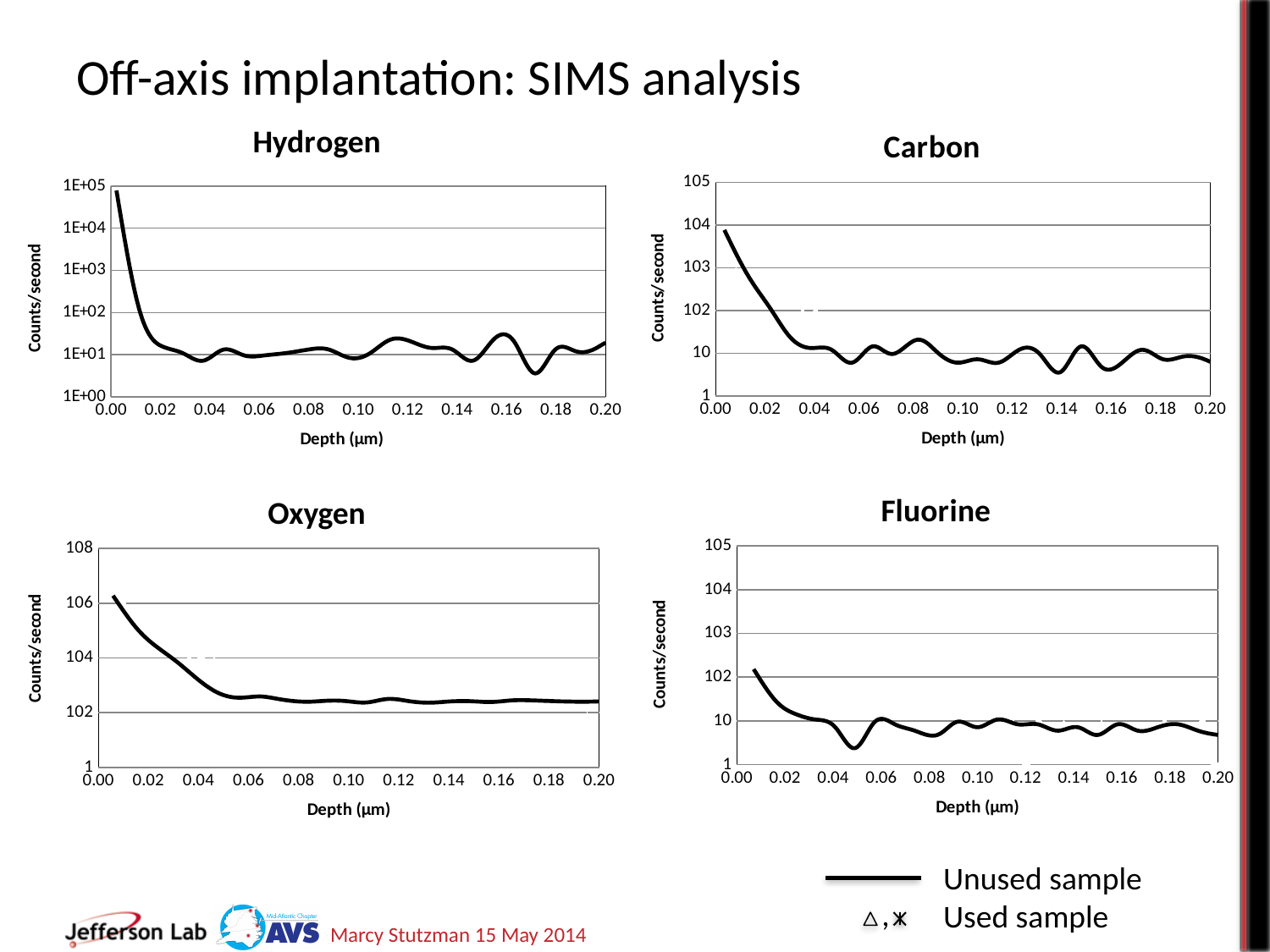
What is the y-axis label of the Oxygen chart? Counts/second In the Oxygen chart, is the value at depth 0.10 greater or less than 10? greater In the Oxygen chart, do the values overall rise or fall as depth increases along the x axis? fall In the Carbon chart, is the value at depth 0.00 greater or less than 10? greater In the Fluorine chart, is the value at depth 0.00 greater or less than 10? greater What kind of chart is the Hydrogen chart? line chart What is the x-axis label of the Carbon chart? Depth (μm) How many charts are shown on the slide? 4 In the Hydrogen chart, do the values overall rise or fall as depth increases from 0.00 to 0.20? fall